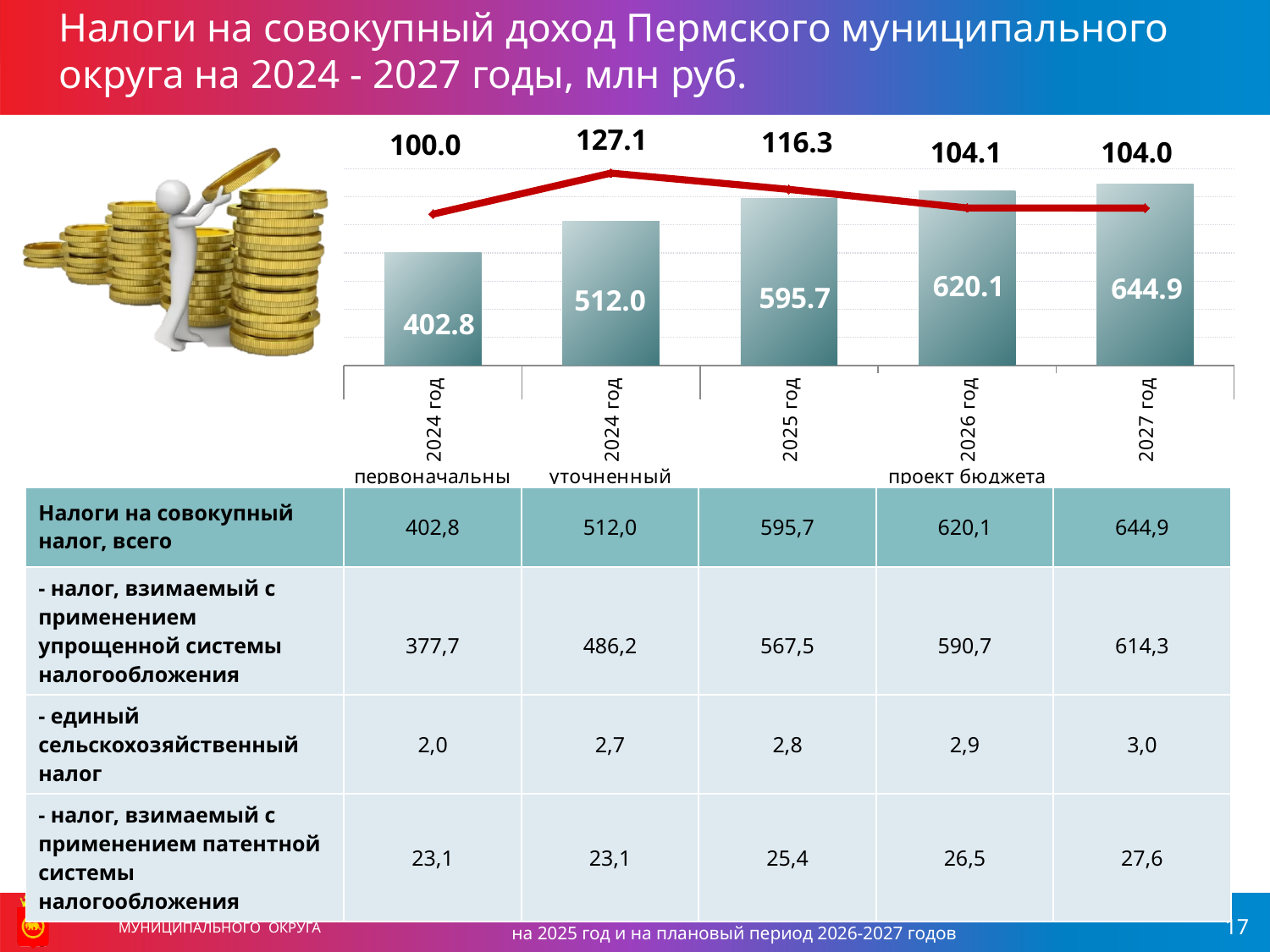
What is the bar value for 2024 год (уточненный)? 512.0 What is the value shown on the red line above the 2027 год bar? 104.0 Which category has the highest bar? 2027 год What is the difference between the bar values for 2024 год (уточненный) and 2024 год (первоначальный)? 109.2 How many bars are plotted in the chart? 5 Which category has the lowest bar? 2024 год (первоначальный) What is the difference between the bar values for 2027 год and 2026 год? 24.8 What is the bar value for 2025 год? 595.7 Do the bar values rise or fall from left to right along the x axis? rise Which is larger, the bar value for 2025 год or for 2026 год? 2026 год What is the value shown on the red line above the 2024 год (уточненный) bar? 127.1 Which category has the highest value on the red line? 2024 год (уточненный)